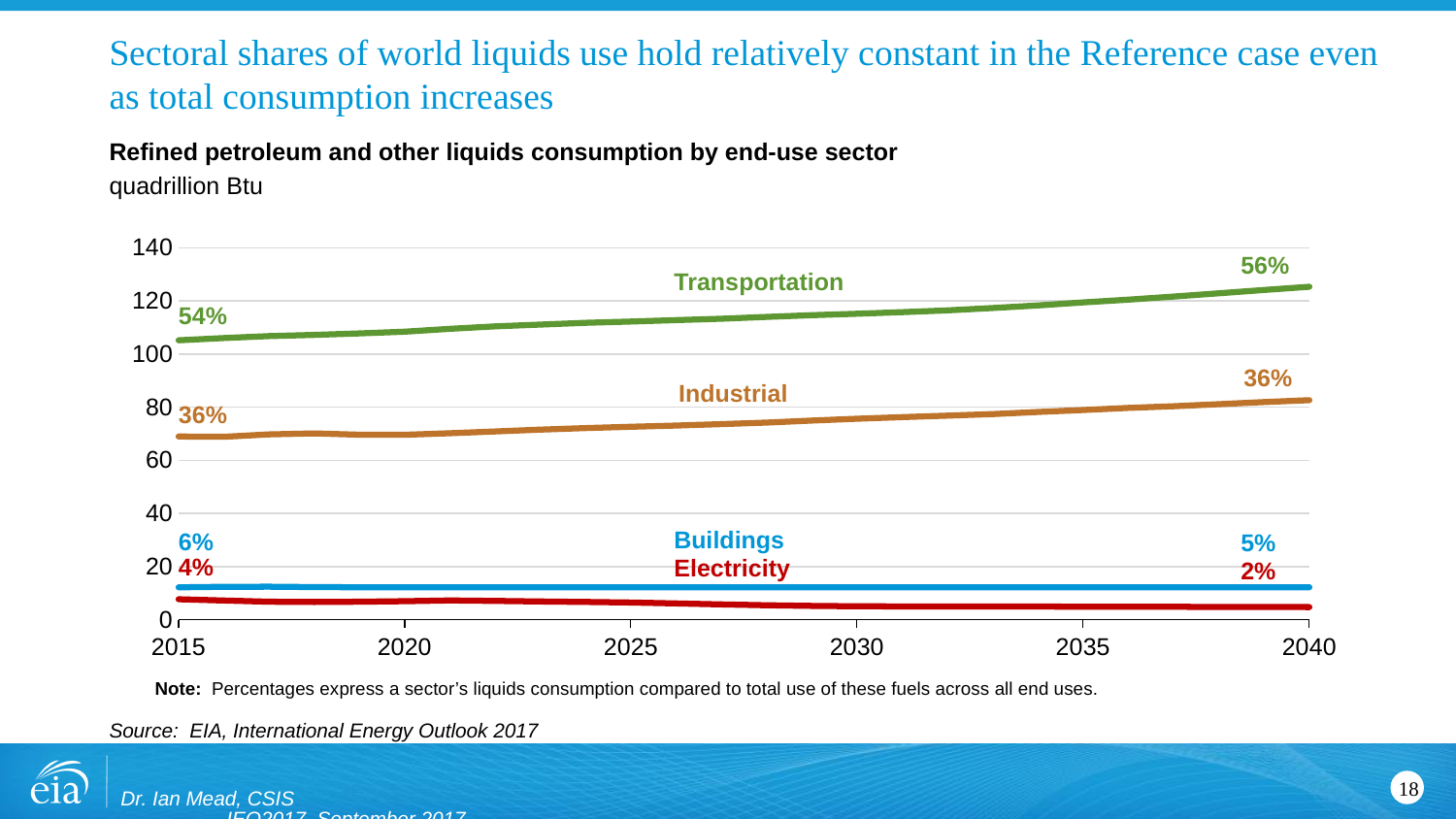
How many end-use sectors are plotted as lines on the chart? 4 What is the Electricity sector's share of liquids consumption in 2015? 4% What kind of chart is shown on the slide? line chart What is the Industrial sector's share of liquids consumption in 2040? 36% What share of world liquids consumption does Transportation account for in 2040? 56% Does Electricity sector liquids consumption rise or fall between 2015 and 2040? fall By how many percentage points does the Buildings share change from 2015 to 2040? 1 percentage point (6% to 5%) Which sector has the lowest liquids consumption in 2040? Electricity What share of world liquids consumption does Transportation account for in 2015? 54% Is the Transportation consumption value in 2015 greater or less than 100 quadrillion Btu? greater Which sector has the highest liquids consumption throughout the projection period? Transportation In what unit is consumption measured on the chart's vertical axis? quadrillion Btu